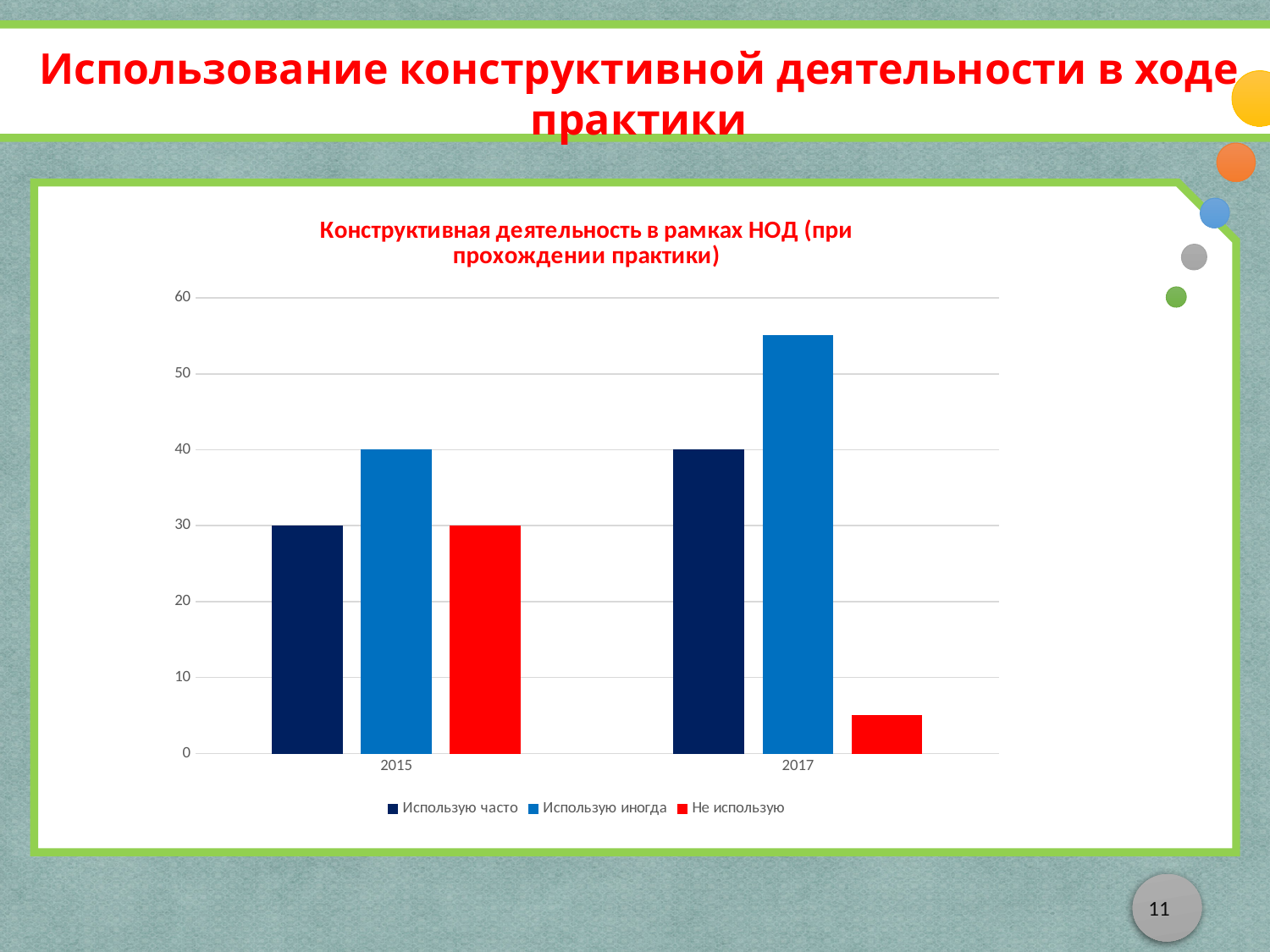
How many series does the legend list? 3 What is the value for "Не использую" in 2015? 30 Which series has the shortest bar in 2017? Не использую What is the value for "Использую часто" in 2015? 30 Which series has the tallest bar in 2017? Использую иногда Is the value for "Не использую" in 2017 greater or less than 10? less What is the value for "Использую иногда" in 2015? 40 What kind of chart is shown on the slide? Bar chart What is the value for "Использую часто" in 2017? 40 Does the value for "Использую часто" rise or fall from 2015 to 2017? Rise Is the value for "Использую иногда" in 2017 greater or less than 50? greater What is the difference between "Использую иногда" and "Использую часто" in 2015? 10